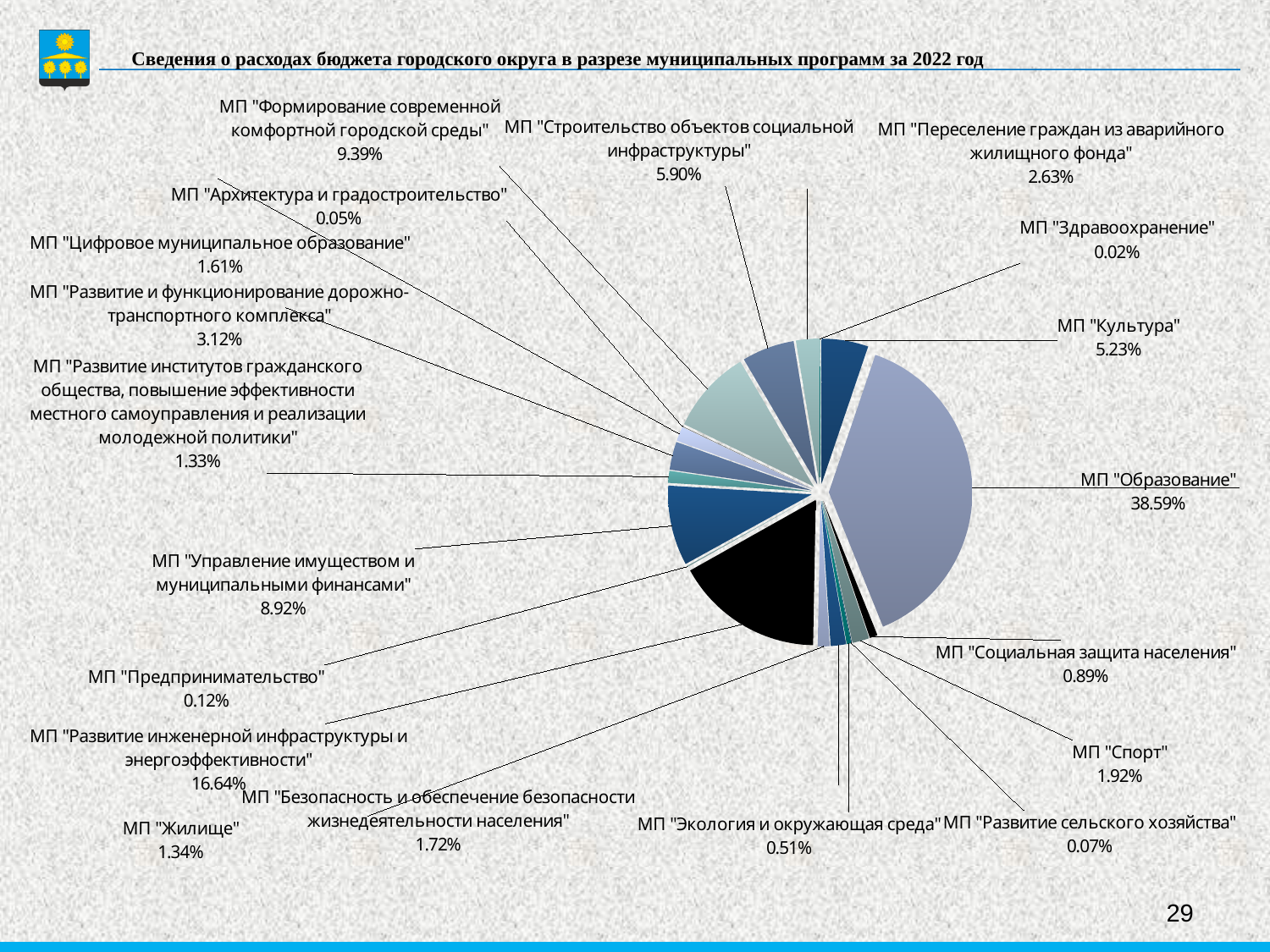
What is the title of the slide? Сведения о расходах бюджета городского округа в разрезе муниципальных программ за 2022 год What percentage is shown for МП "Спорт"? 1.92% Which has a larger share: МП "Формирование современной комфортной городской среды" or МП "Управление имуществом и муниципальными финансами"? МП "Формирование современной комфортной городской среды" What percentage is shown for МП "Развитие инженерной инфраструктуры и энергоэффективности"? 16.64% Which municipal program has the smallest share of the pie? МП "Здравоохранение" What share of budget expenditure goes to МП "Образование"? 38.59% How many municipal programs (slices) are shown in the pie chart? 19 What is the difference in percentage points between МП "Образование" and МП "Развитие инженерной инфраструктуры и энергоэффективности"? 21.95 What percentage is shown for МП "Культура"? 5.23% Which has a larger share: МП "Строительство объектов социальной инфраструктуры" or МП "Культура"? МП "Строительство объектов социальной инфраструктуры" What kind of chart is shown on the slide? Pie chart Which municipal program has the largest share of the pie? МП "Образование"